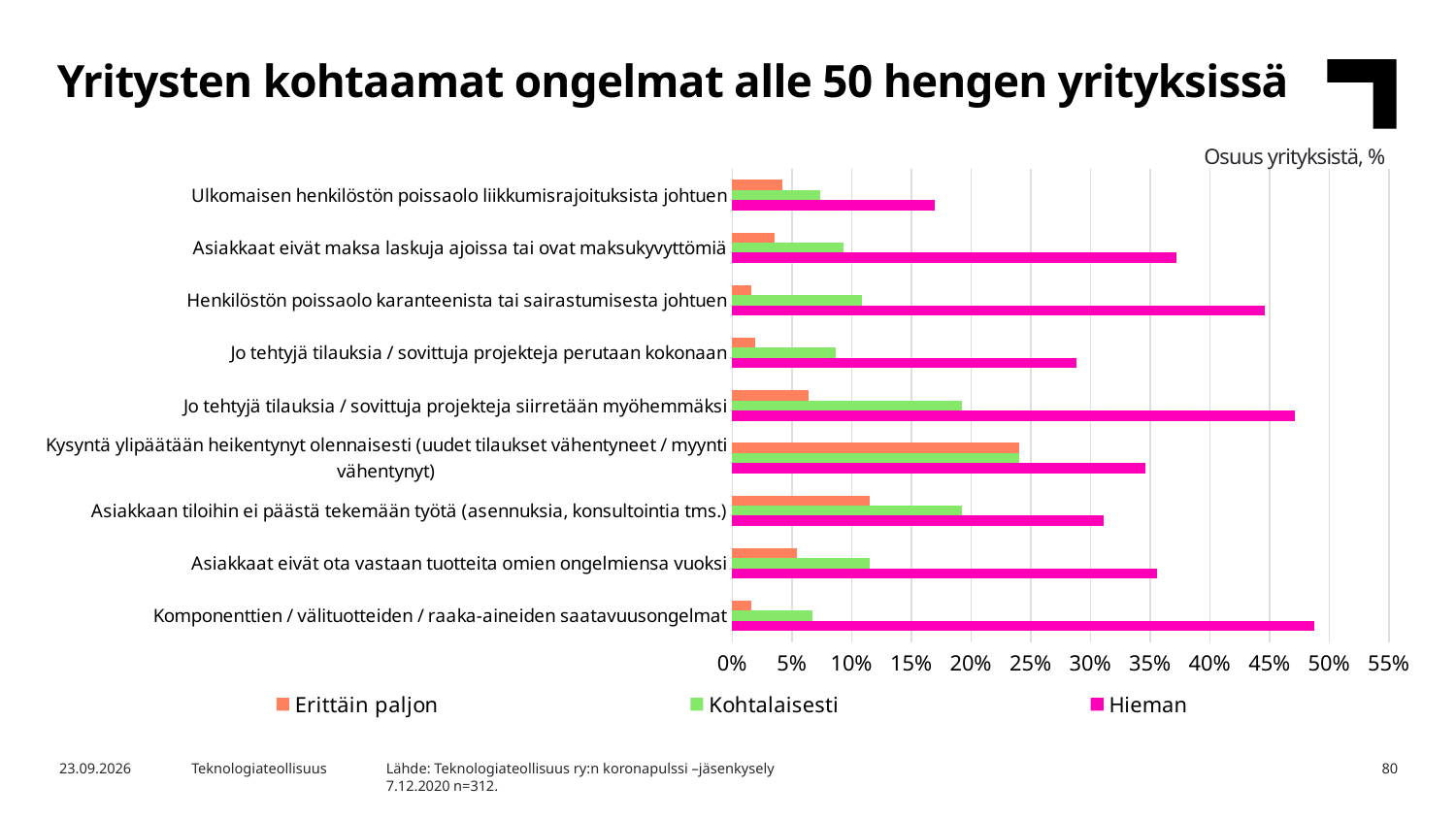
Is the 'Hieman' value for 'Ulkomaisen henkilöstön poissaolo liikkumisrajoituksista johtuen' greater or less than 20%? less How many series does the legend list? 3 What kind of chart is shown on the slide? Bar chart How many categories (problems) are plotted on the chart? 9 For the 'Hieman' series, which is larger: 'Asiakkaat eivät maksa laskuja ajoissa tai ovat maksukyvyttömiä' or 'Jo tehtyjä tilauksia / sovittuja projekteja perutaan kokonaan'? Asiakkaat eivät maksa laskuja ajoissa tai ovat maksukyvyttömiä What colour represents the 'Hieman' series in the chart? Magenta (pink) Which category has the highest value for the 'Erittäin paljon' series? Kysyntä ylipäätään heikentynyt olennaisesti (uudet tilaukset vähentyneet / myynti vähentynyt) Is the 'Erittäin paljon' value for 'Kysyntä ylipäätään heikentynyt olennaisesti' greater or less than 20%? greater For the 'Erittäin paljon' series, which is larger: 'Asiakkaan tiloihin ei päästä tekemään työtä' or 'Asiakkaat eivät ota vastaan tuotteita omien ongelmiensa vuoksi'? Asiakkaan tiloihin ei päästä tekemään työtä Is the 'Hieman' value for 'Henkilöstön poissaolo karanteenista tai sairastumisesta johtuen' greater or less than 40%? greater What unit label is shown above the chart's value axis? Osuus yrityksistä, % Which category has the lowest value for the 'Hieman' series? Ulkomaisen henkilöstön poissaolo liikkumisrajoituksista johtuen